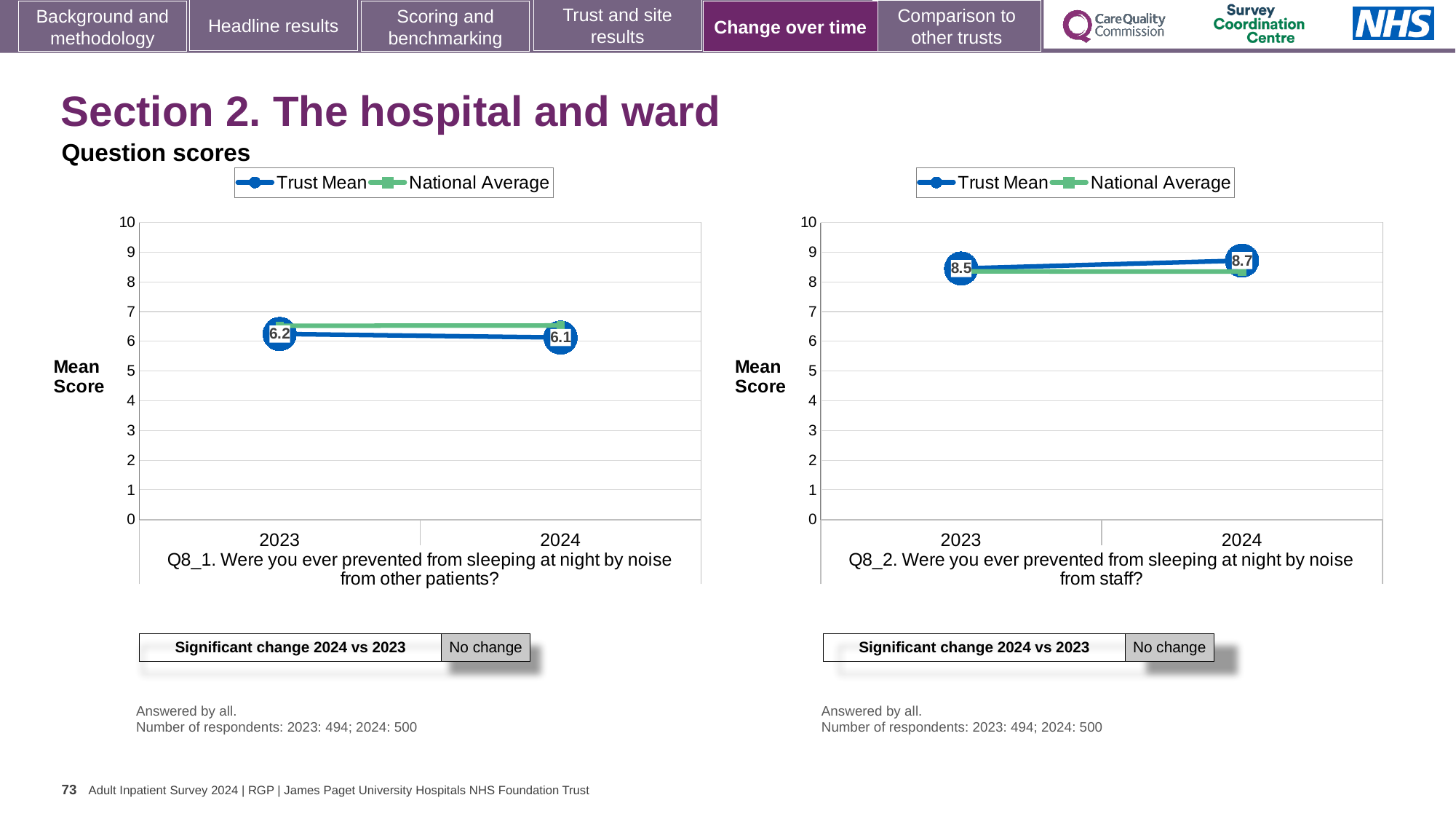
In the Q8_1 chart (left), what is the Trust Mean for 2023? 6.2 In the Q8_2 chart (right), what is the Trust Mean for 2024? 8.7 How many years are plotted on the x axis of the Q8_1 chart (left)? 2 What is the y-axis label on the Q8_1 chart (left)? Mean Score In the Q8_2 chart (right), by how much did the Trust Mean change from 2023 to 2024? 0.2 How many series does the legend of the Q8_2 chart (right) list? 2 In the Q8_2 chart (right), what is the Trust Mean for 2023? 8.5 In the Q8_2 chart (right), does the Trust Mean rise or fall from 2023 to 2024? rise In the Q8_1 chart (left), what is the Trust Mean for 2024? 6.1 In the Q8_1 chart (left), does the Trust Mean rise or fall from 2023 to 2024? fall In the Q8_2 chart (right), is the National Average for 2023 greater or less than 5? greater What kind of chart is the Q8_1 chart (left)? line chart